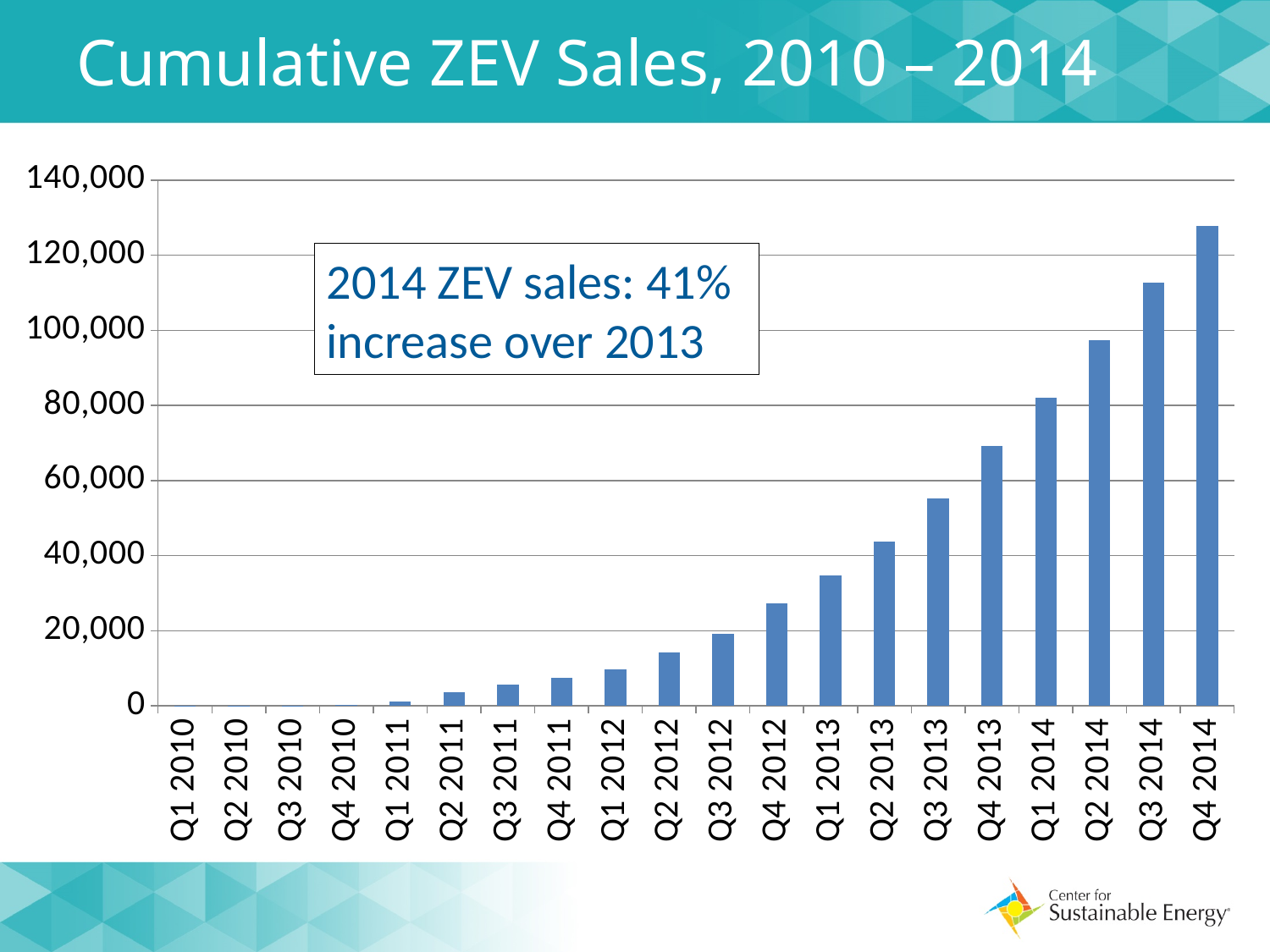
Do the values rise or fall from Q1 2010 to Q4 2014? rise Is the value for Q2 2014 greater or less than 100,000? less Is the value for Q3 2014 greater or less than 100,000? greater Is the value for Q4 2012 greater or less than 20,000? greater Which quarter has the highest cumulative ZEV sales? Q4 2014 What kind of chart is shown on the slide? bar chart What is the title of the chart? Cumulative ZEV Sales, 2010 – 2014 According to the text box on the chart, by what percentage did 2014 ZEV sales increase over 2013? 41% Which is larger, the value for Q4 2013 or the value for Q1 2013? Q4 2013 How many quarters are plotted along the x axis? 20